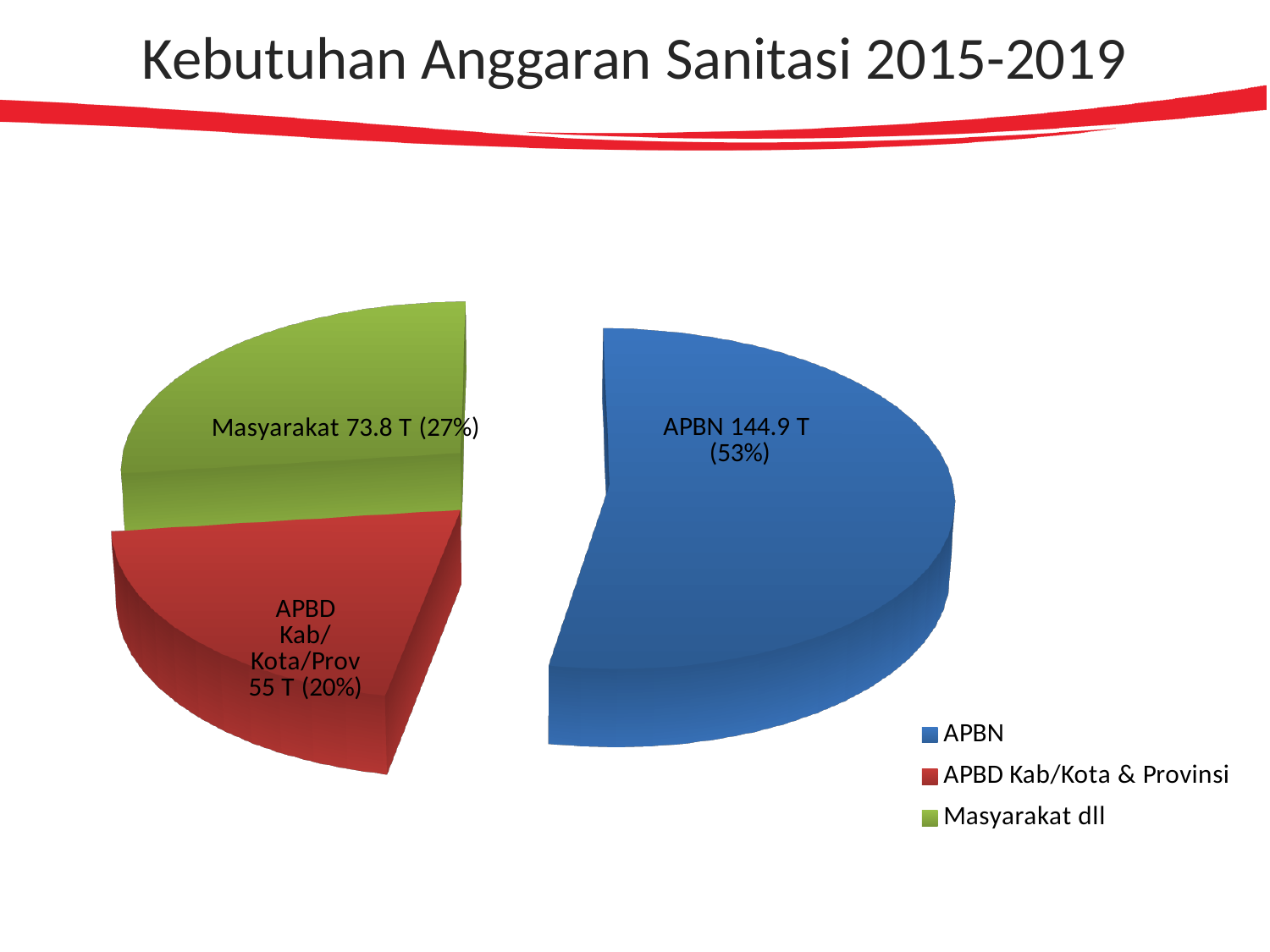
Which slice of the pie is the smallest? APBD Kab/Kota/Prov What is the value shown for Masyarakat? 73.8 T Which is larger, the Masyarakat value or the APBD Kab/Kota/Prov value? Masyarakat What share of the pie does Masyarakat represent? 27% What is the value shown for APBN? 144.9 T Which slice of the pie is the largest? APBN How many slices does the pie chart have? 3 What is the difference between the APBN value and the Masyarakat value? 71.1 T What type of chart is shown on the slide? Pie chart What is the value shown for APBD Kab/Kota/Prov? 55 T What share of the pie does APBN represent? 53% What is the title of the slide? Kebutuhan Anggaran Sanitasi 2015-2019